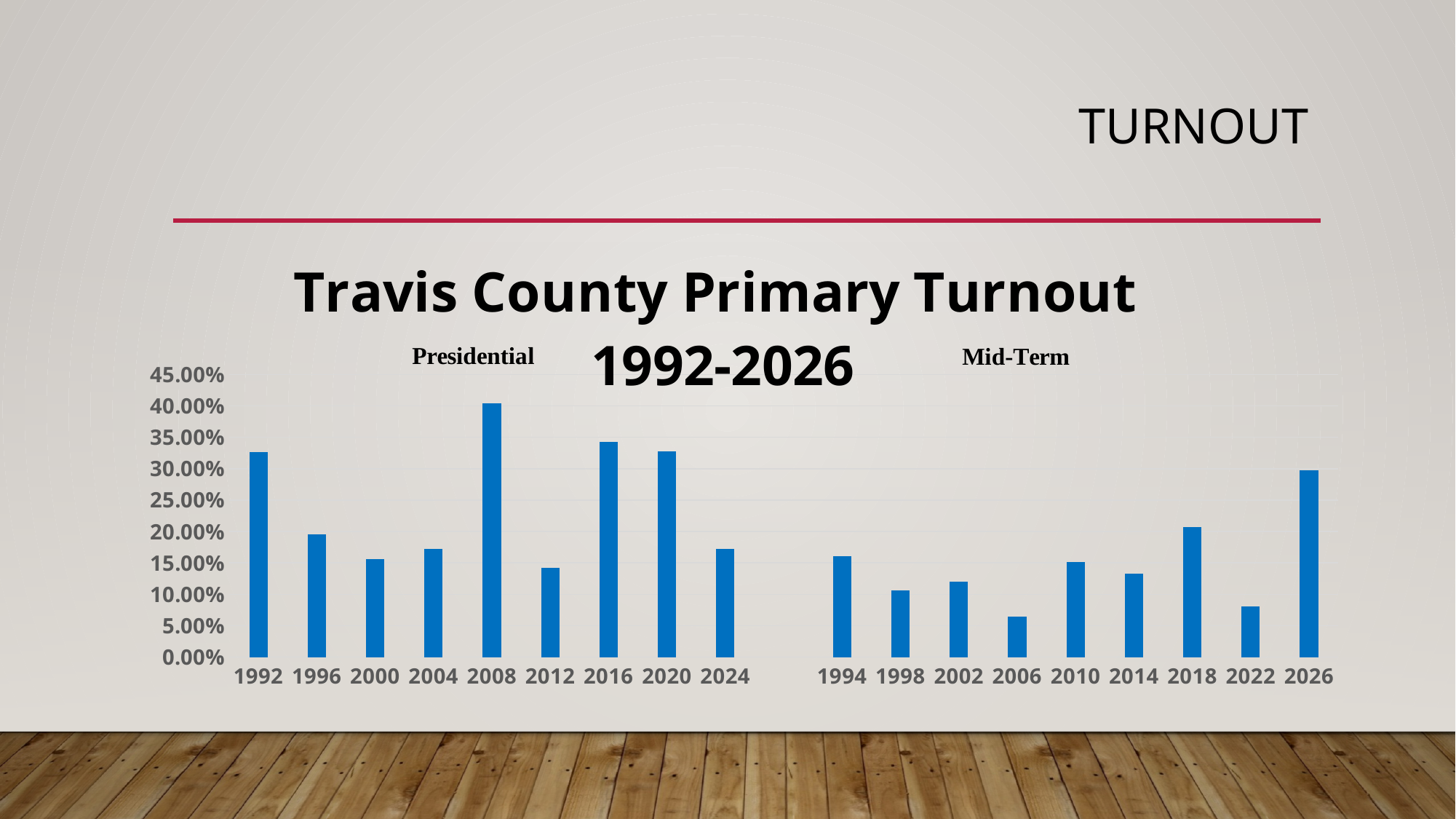
What kind of chart is shown on the slide? bar chart How many years are plotted in the chart? 18 Which mid-term year has the highest turnout? 2026 Is the turnout for 2006 greater or less than 10.00%? less Which year has the lowest turnout in the chart? 2006 Which year has the higher turnout, 2018 or 2022? 2018 What is the title of the chart? Travis County Primary Turnout 1992-2026 Which year has the highest turnout in the chart? 2008 Is the turnout for 2012 greater or less than 20.00%? less Is the turnout for 2026 greater or less than 25.00%? greater Which year has the higher turnout, 2016 or 2024? 2016